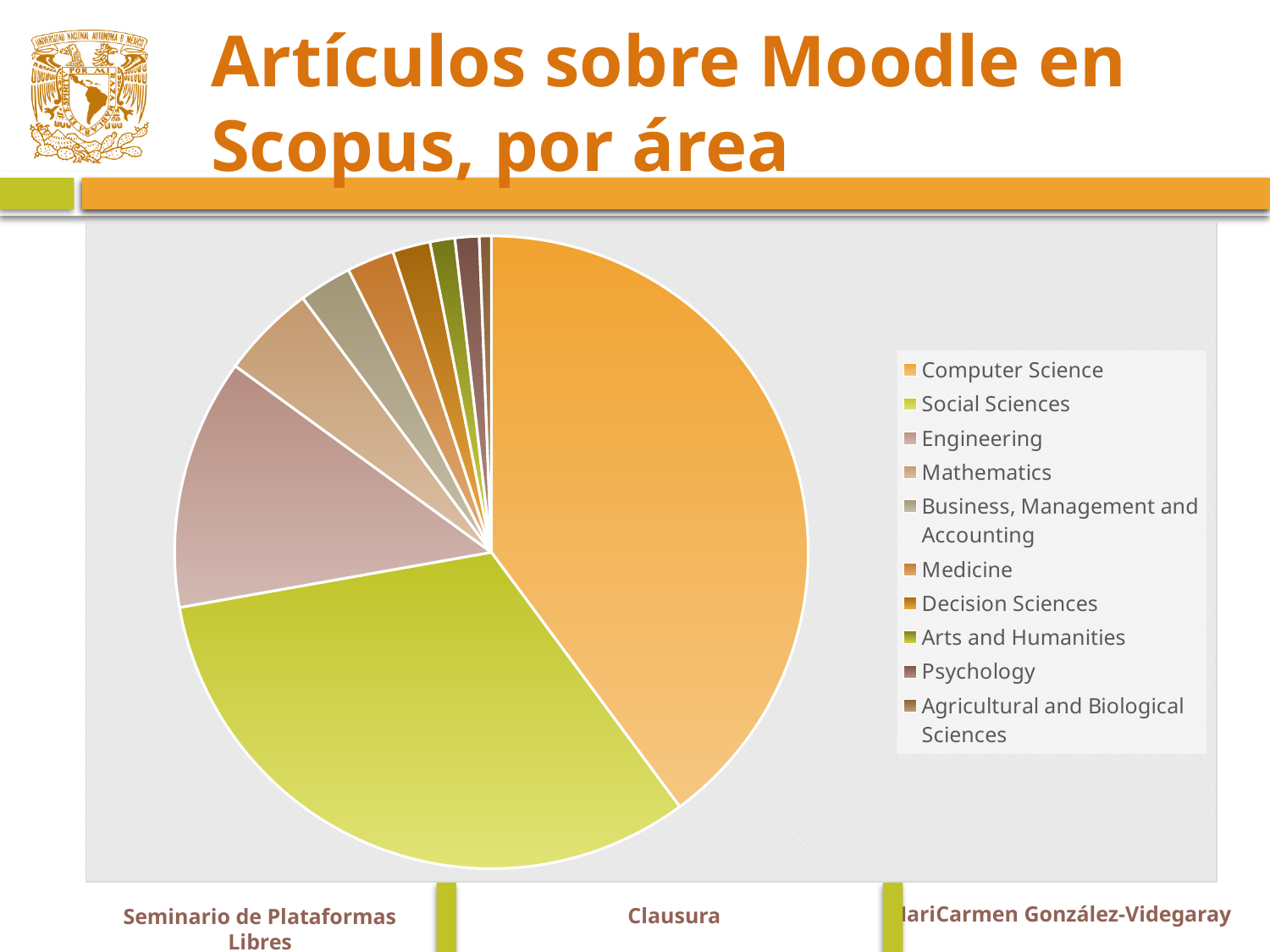
How many categories (slices) does the pie chart have? 10 Which area is the second largest slice of the pie chart? Social Sciences What kind of chart is shown on the slide? pie chart Which slice is larger, Social Sciences or Engineering? Social Sciences Which slice is larger, Engineering or Mathematics? Engineering Which area has the smallest slice of the pie chart? Agricultural and Biological Sciences Which area has the largest slice of the pie chart? Computer Science What colour is used for the Computer Science slice in the legend? orange What is the title of the chart on the slide? Artículos sobre Moodle en Scopus, por área Which slice is larger, Mathematics or Psychology? Mathematics